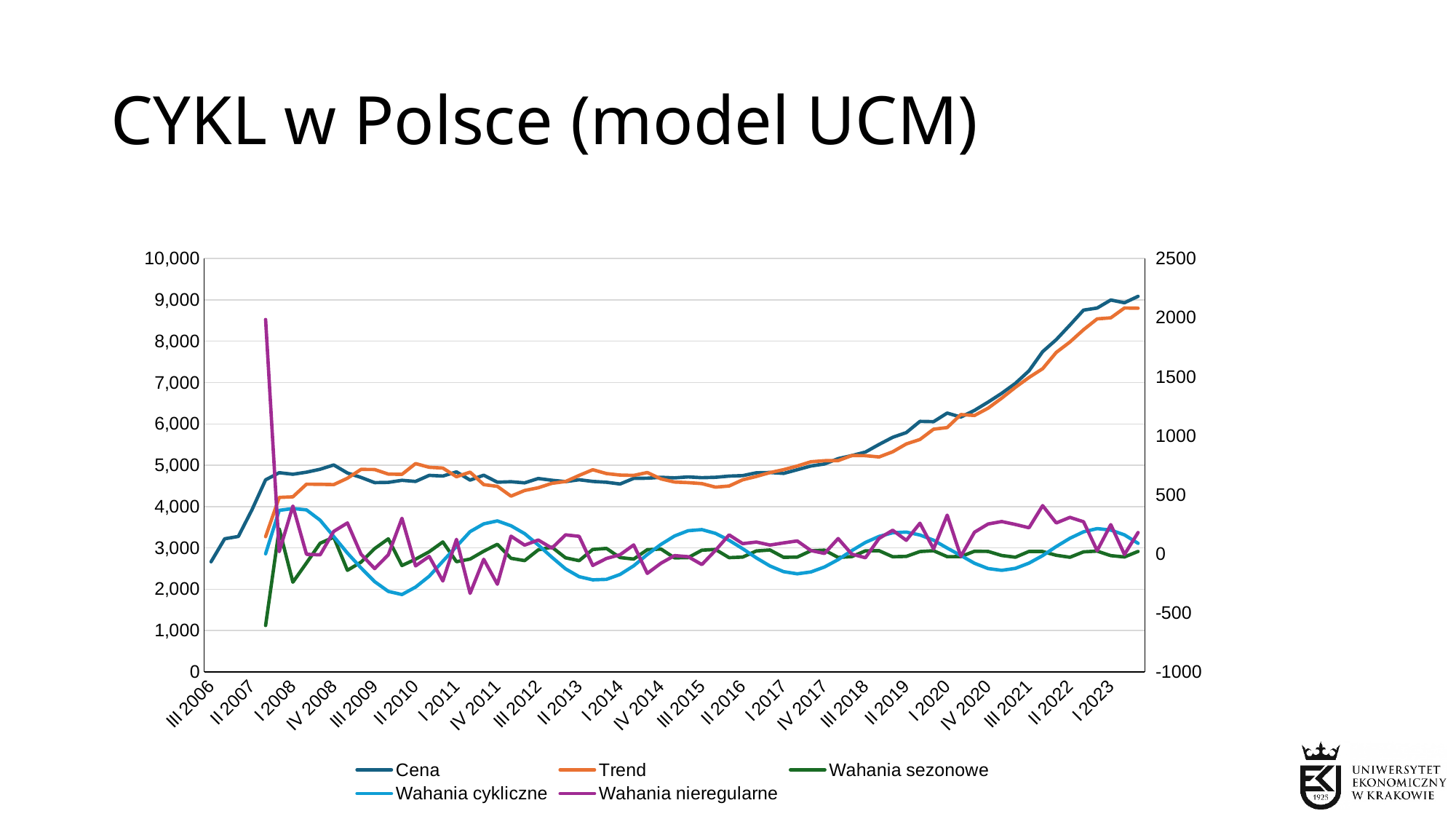
Is the value of Cena at III 2006 greater or less than 4,000? less How many series does the legend list? 5 Is the value of Trend at I 2016 greater or less than 6,000? less What kind of chart is shown on the slide? line chart Is the value of Trend at I 2023 greater or less than 8,000? greater What is the title of the slide containing the chart? CYKL w Polsce (model UCM) At I 2023, which series has the highest value on the chart? Cena Which is larger: the value of Cena at I 2023 or the value of Cena at III 2006? Cena at I 2023 Does the Cena series rise or fall overall from III 2006 to I 2023? rise Which is larger at I 2023: Cena or Trend? Cena Which series is drawn in orange? Trend